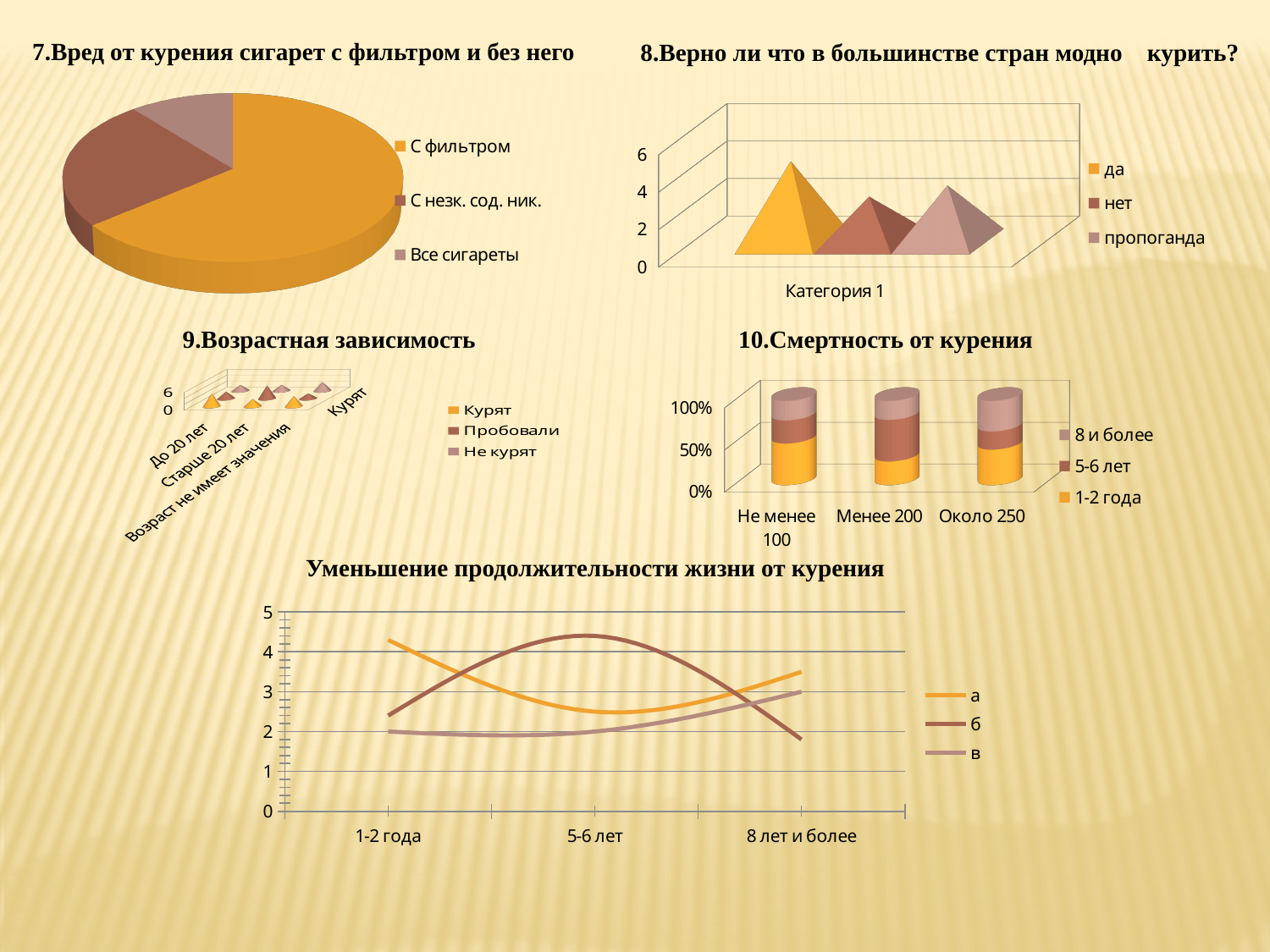
In the bottom chart ("Уменьшение продолжительности жизни от курения"), is the value of series а at "1-2 года" greater or less than 4? greater How many series does the legend of chart 8 ("Верно ли что в большинстве стран модно курить?") list? 3 How many series does the legend of chart 9 ("Возрастная зависимость") list? 3 In chart 8 ("Верно ли что в большинстве стран модно курить?"), which series has the highest value? да What kind of chart is chart 7 ("Вред от курения сигарет с фильтром и без него")? pie chart In the bottom chart ("Уменьшение продолжительности жизни от курения"), which series is larger at "5-6 лет": а or б? б How many slices does the pie chart 7 ("Вред от курения сигарет с фильтром и без него") have? 3 What kind of chart is the bottom chart ("Уменьшение продолжительности жизни от курения")? line chart In chart 7 ("Вред от курения сигарет с фильтром и без него"), which slice is the largest? С фильтром What kind of chart is chart 10 ("Смертность от курения")? bar chart In chart 8 ("Верно ли что в большинстве стран модно курить?"), is the value for "да" greater or less than 4? greater How many categories are shown on the x axis of chart 10 ("Смертность от курения")? 3